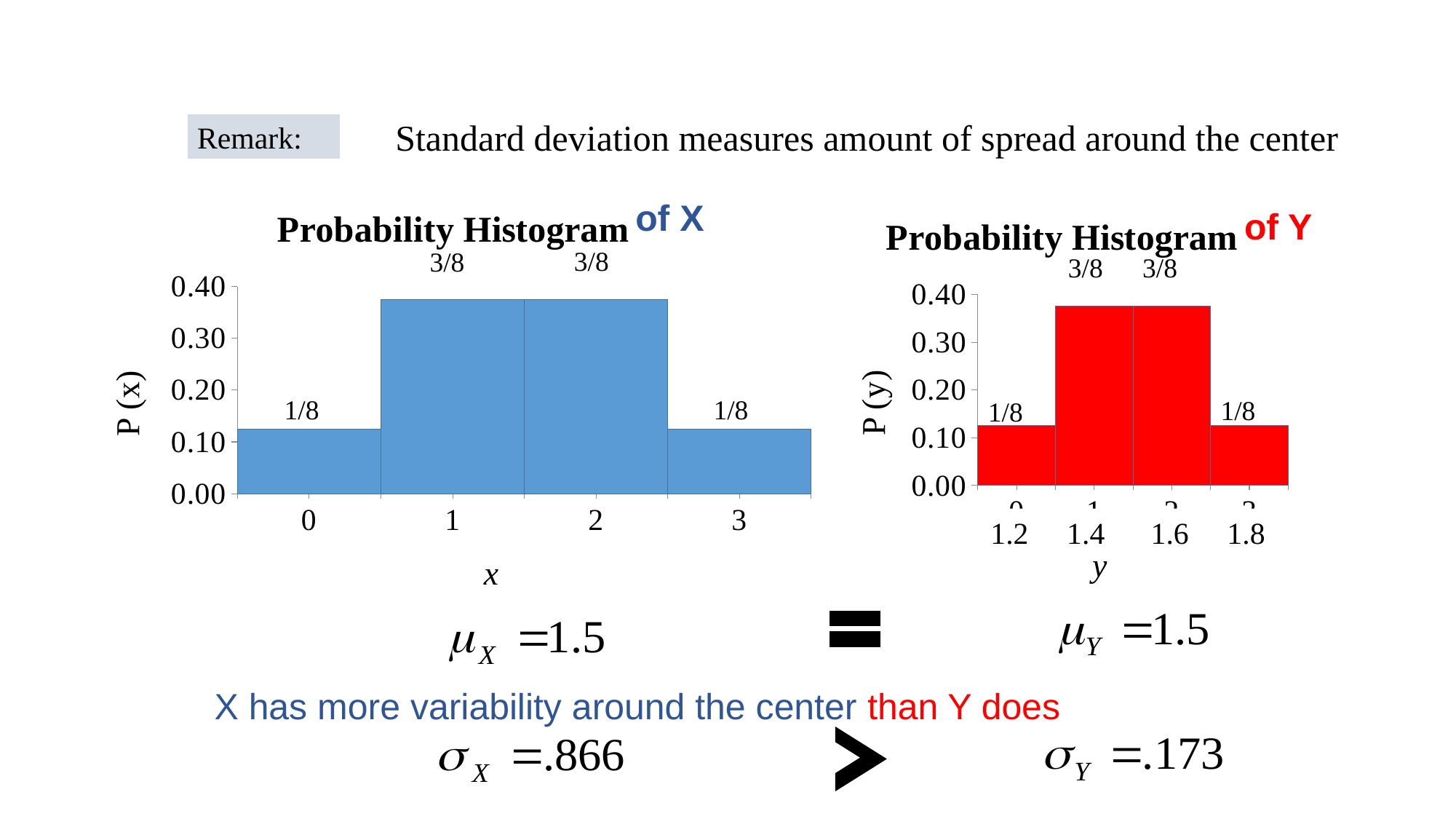
What is the y-axis label of the Probability Histogram of X? P (x) In the Probability Histogram of X, what is the value for x = 3? 1/8 In the Probability Histogram of X, what is the value for x = 1? 3/8 In the Probability Histogram of X, what is the value for x = 0? 1/8 In the Probability Histogram of Y, is the value of the rightmost bar greater or less than 0.20? less In the Probability Histogram of X, is the value for x = 2 larger than the value for x = 3? Yes In the Probability Histogram of X, is the value for x = 0 greater or less than 0.20? less What kind of chart is the Probability Histogram of Y? Bar chart In the Probability Histogram of X, is the value for x = 1 greater or less than 0.30? greater In the Probability Histogram of Y, what is the value of the leftmost bar? 1/8 In the Probability Histogram of Y, how many bars are plotted? 4 In the Probability Histogram of X, how many bars are plotted? 4